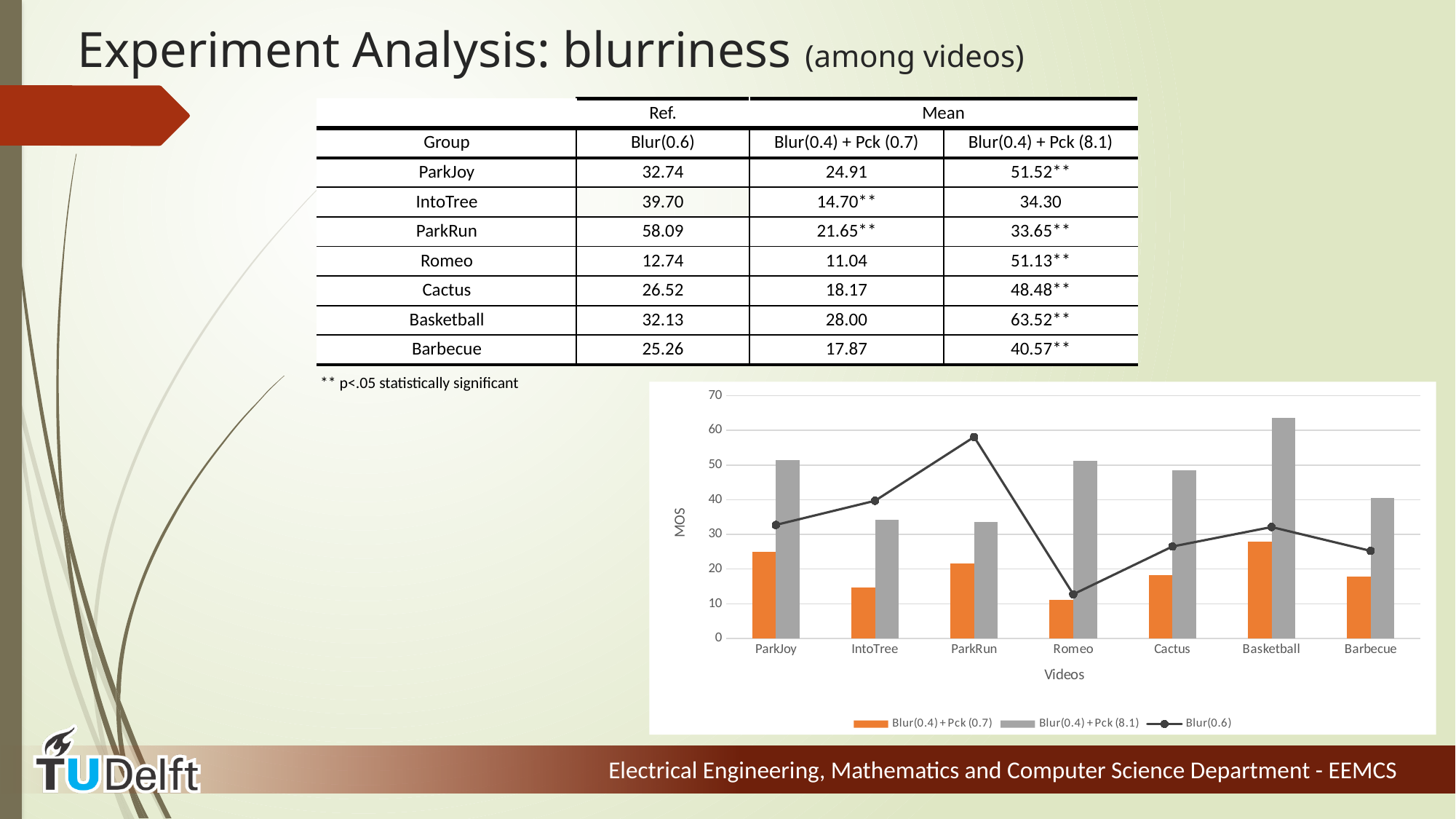
For ParkRun, which is larger: the Blur(0.6) value or the Blur(0.4) + Pck (8.1) value? Blur(0.6) What is the Blur(0.6) value for ParkRun? 58.09 Which video has the lowest Blur(0.4) + Pck (0.7) value? Romeo What is the difference between the Blur(0.4) + Pck (8.1) and Blur(0.4) + Pck (0.7) values for Basketball? 35.52 How many series does the chart legend list? 3 How many videos are shown along the x axis of the chart? 7 Does the Blur(0.6) line rise or fall from ParkRun to Romeo? fall Which video has the highest Blur(0.6) value? ParkRun Which video has the highest Blur(0.4) + Pck (8.1) value? Basketball What is the label on the chart's y axis? MOS Is the Blur(0.4) + Pck (8.1) value for Romeo greater or less than 40? greater What kind of chart is shown on the slide? A bar chart combined with a line series